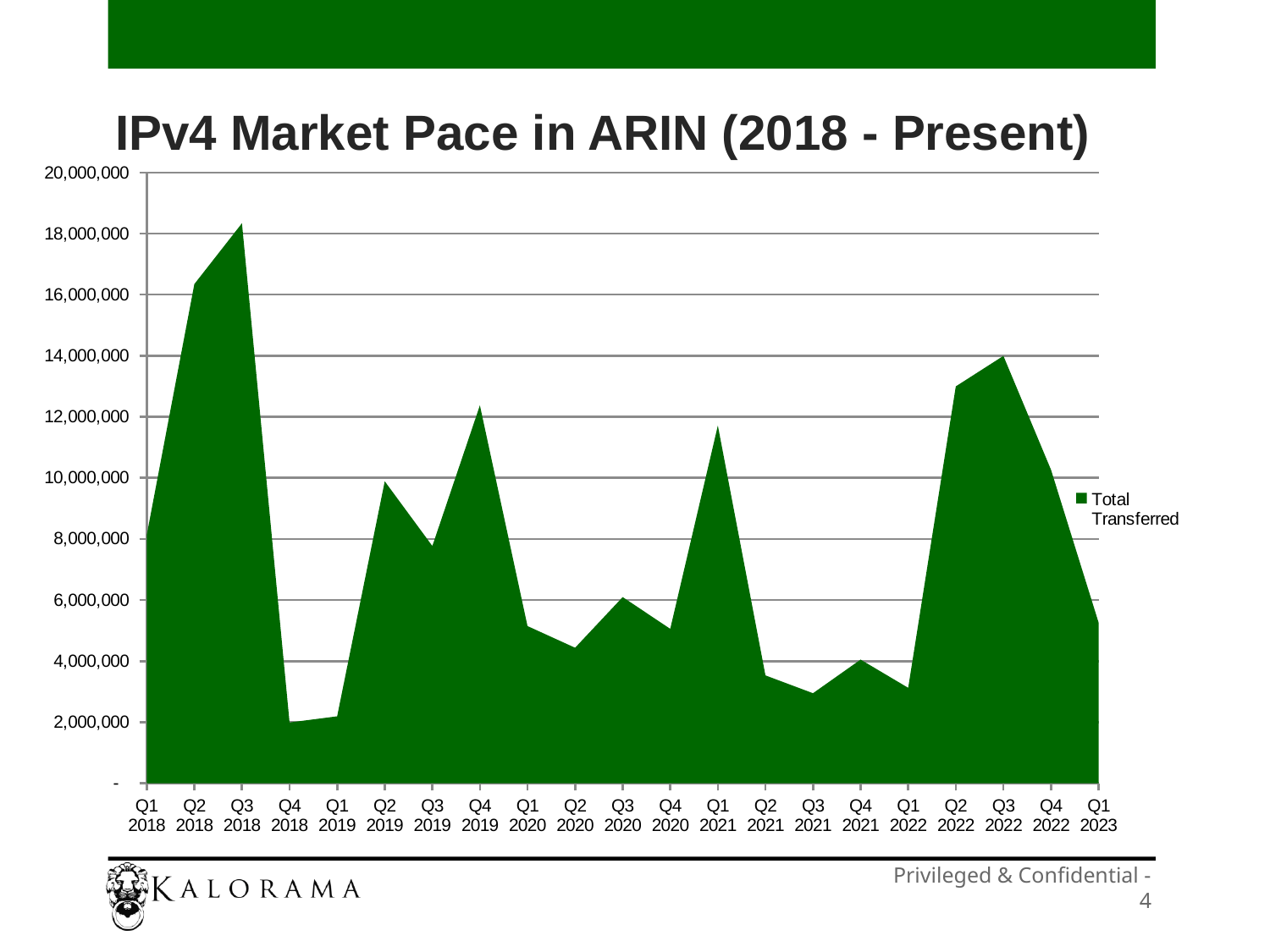
Is the value for Q4 2018 greater or less than 4,000,000? less Is the value for Q1 2021 greater or less than 10,000,000? greater Which is larger, the value for Q3 2018 or the value for Q3 2022? Q3 2018 Is the value for Q2 2022 greater or less than 12,000,000? greater How many series does the legend list? 1 What kind of chart is shown on the slide? Area chart Which quarter has the highest value for Total Transferred? Q3 2018 What is the name of the series shown in the legend? Total Transferred How many quarters are plotted along the x axis? 21 Do the values rise or fall from Q3 2022 to Q1 2023? fall Which is larger, the value for Q2 2019 or the value for Q2 2020? Q2 2019